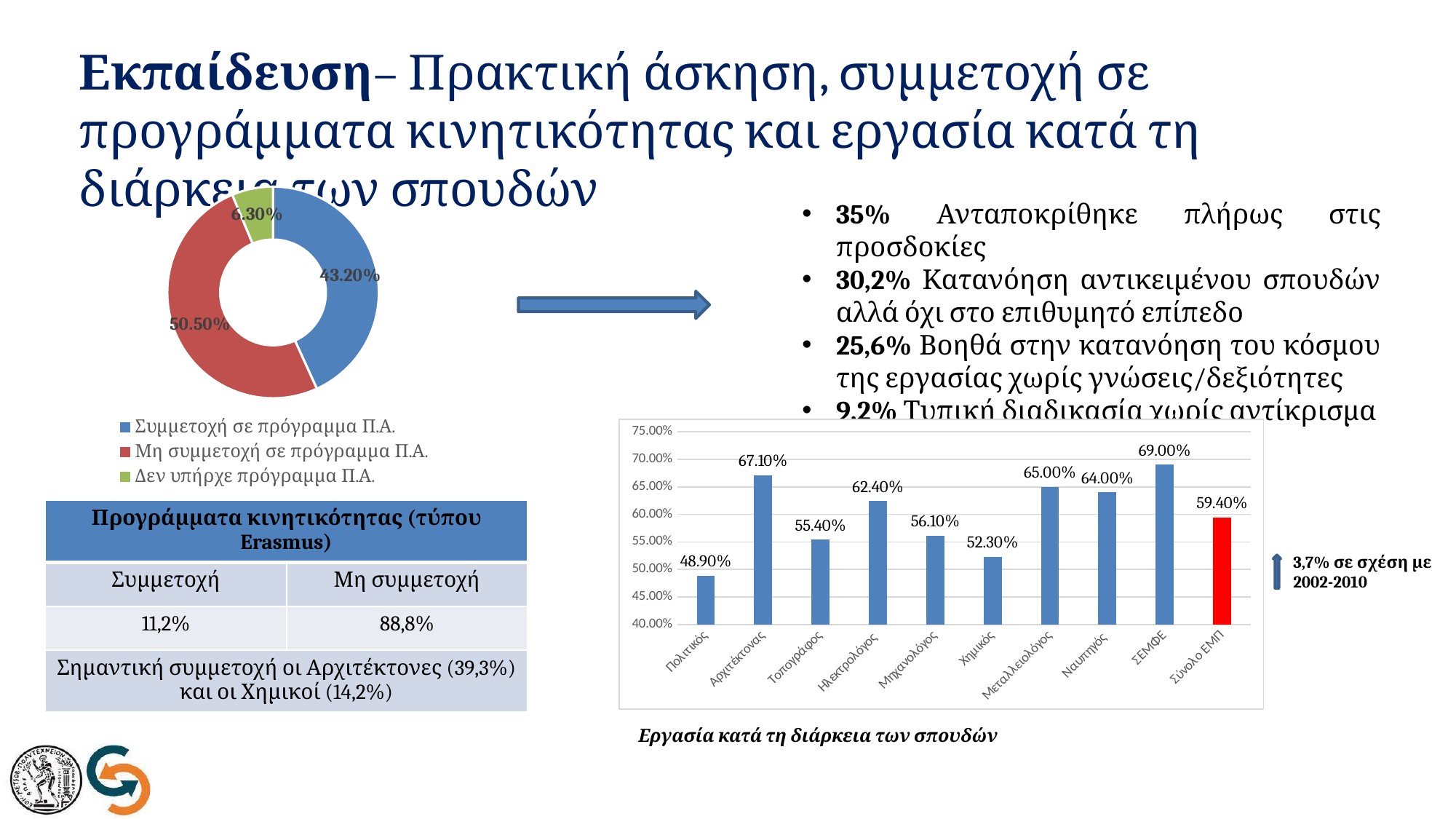
In the doughnut chart at the top left, how many categories does the legend list? 3 In the chart 'Εργασία κατά τη διάρκεια των σπουδών', what is the value for Σύνολο ΕΜΠ? 59.40% What type of chart is 'Εργασία κατά τη διάρκεια των σπουδών'? Bar chart In the chart 'Εργασία κατά τη διάρκεια των σπουδών', what is the value for Αρχιτέκτονας? 67.10% In the chart 'Εργασία κατά τη διάρκεια των σπουδών', what is the difference between ΣΕΜΦΕ and Πολιτικός? 20.10% In the doughnut chart at the top left, which category has the smallest share? Δεν υπήρχε πρόγραμμα Π.Α. In the doughnut chart at the top left, what is the value for 'Μη συμμετοχή σε πρόγραμμα Π.Α.'? 50.50% In the chart 'Εργασία κατά τη διάρκεια των σπουδών', how many categories are shown on the x axis? 10 In the chart 'Εργασία κατά τη διάρκεια των σπουδών', which category has the lowest value? Πολιτικός In the doughnut chart at the top left, what is the difference between 'Μη συμμετοχή σε πρόγραμμα Π.Α.' and 'Συμμετοχή σε πρόγραμμα Π.Α.'? 7.30% In the chart 'Εργασία κατά τη διάρκεια των σπουδών', which is larger, Μεταλλειολόγος or Ναυπηγός? Μεταλλειολόγος In the chart 'Εργασία κατά τη διάρκεια των σπουδών', which category has the highest value? ΣΕΜΦΕ